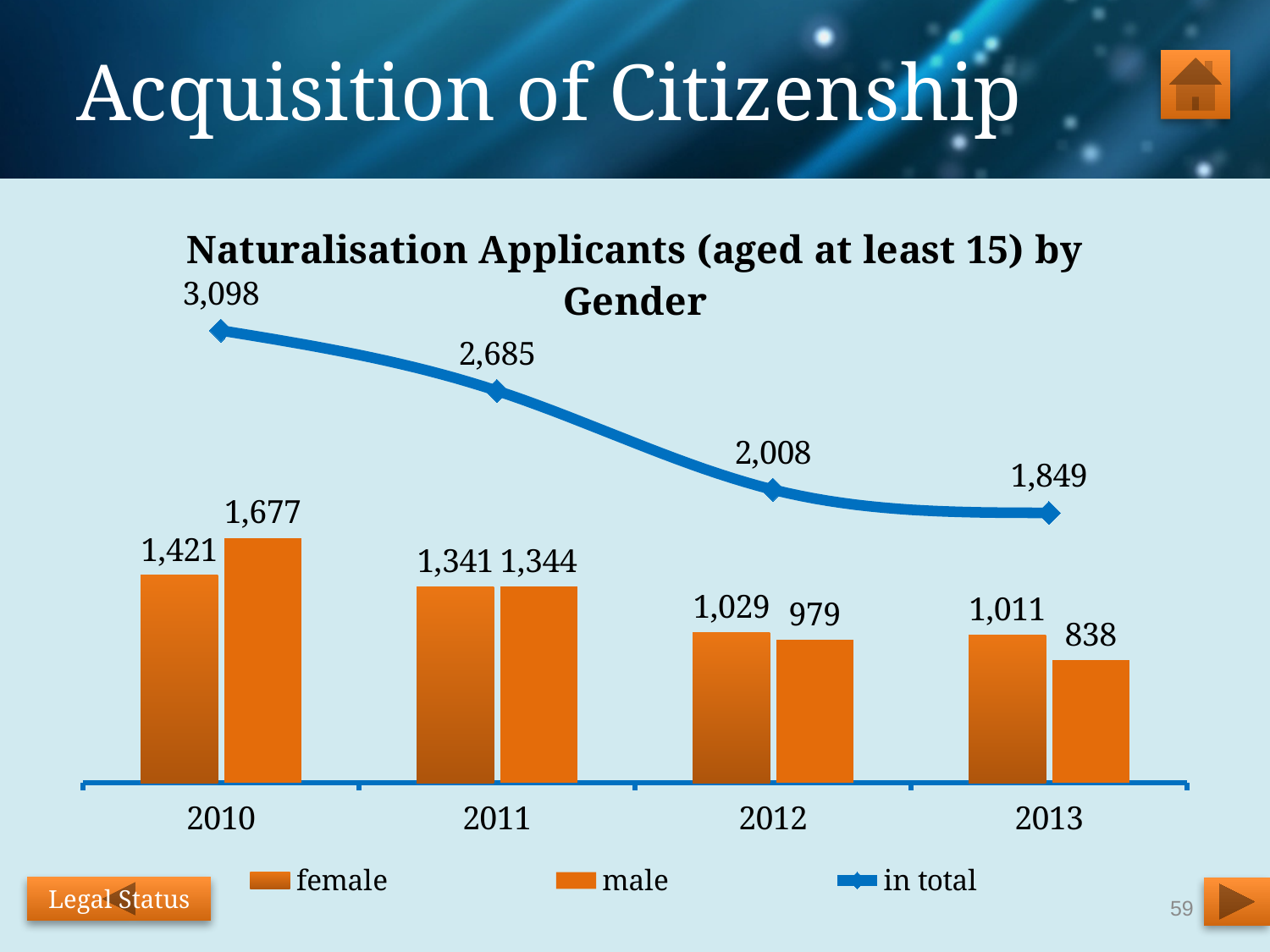
In which year was the total number of naturalisation applicants highest? 2010 How many female naturalisation applicants were there in 2013? 1,011 What kind of chart is shown on the slide? combined bar and line chart How many series does the legend list? 3 What is the total number of naturalisation applicants in 2010? 3,098 In 2010, were there more female or male applicants? male How many years are shown on the x axis of the chart? 4 What is the title of the chart? Naturalisation Applicants (aged at least 15) by Gender Does the total number of applicants rise or fall from 2010 to 2013? fall In which year was the number of male applicants lowest? 2013 How many male naturalisation applicants were there in 2012? 979 What is the difference between the total number of applicants in 2010 and in 2013? 1,249